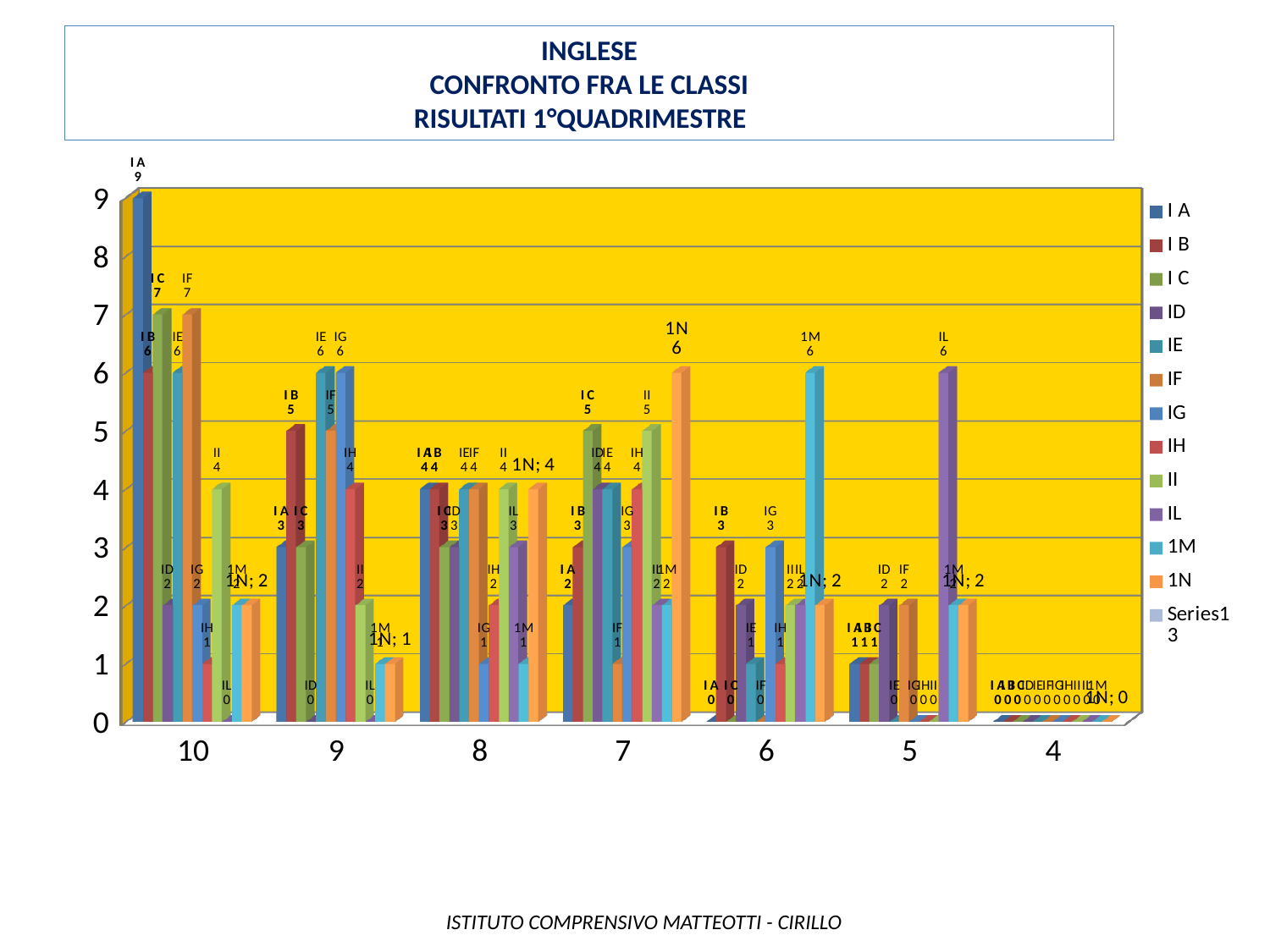
How many series does the chart legend list? 13 Is the value for series I B larger in category 10 or in category 9? 10 How many categories are shown along the x axis of the chart? 7 What is the value for series IF in category 10? 7 What is the value for series 1N in category 7? 6 What is the value for series 1M in category 6? 6 What is the first line of the chart's title? INGLESE What is the value for series IL in category 5? 6 What is the value for series I A in category 10? 9 What kind of chart is shown on the slide? bar chart What is the difference between the values of I A and I C in category 10? 2 Which series has the highest value in category 10? I A